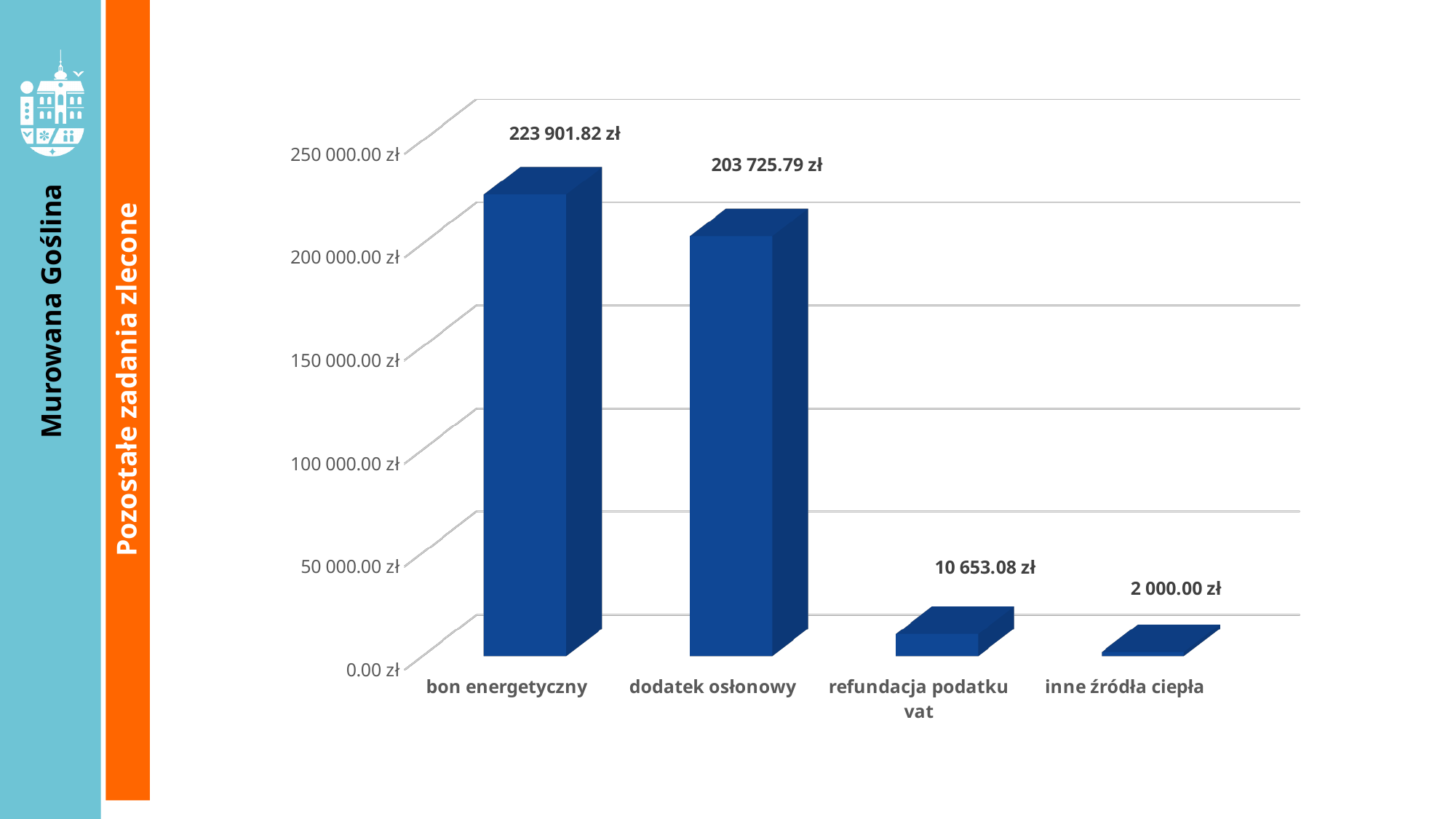
Which is larger, the value for dodatek osłonowy or the value for refundacja podatku vat? dodatek osłonowy What is the value for inne źródła ciepła? 2 000.00 zł How many categories are shown on the chart? 4 What is the difference between the values for refundacja podatku vat and inne źródła ciepła? 8 653.08 zł What is the value for refundacja podatku vat? 10 653.08 zł What is the value for bon energetyczny? 223 901.82 zł Which category has the highest value? bon energetyczny Which category has the lowest value? inne źródła ciepła What is the difference between the values for bon energetyczny and dodatek osłonowy? 20 176.03 zł Is the value for bon energetyczny greater or less than 200 000.00 zł? greater What kind of chart is shown on the slide? bar chart What is the value for dodatek osłonowy? 203 725.79 zł